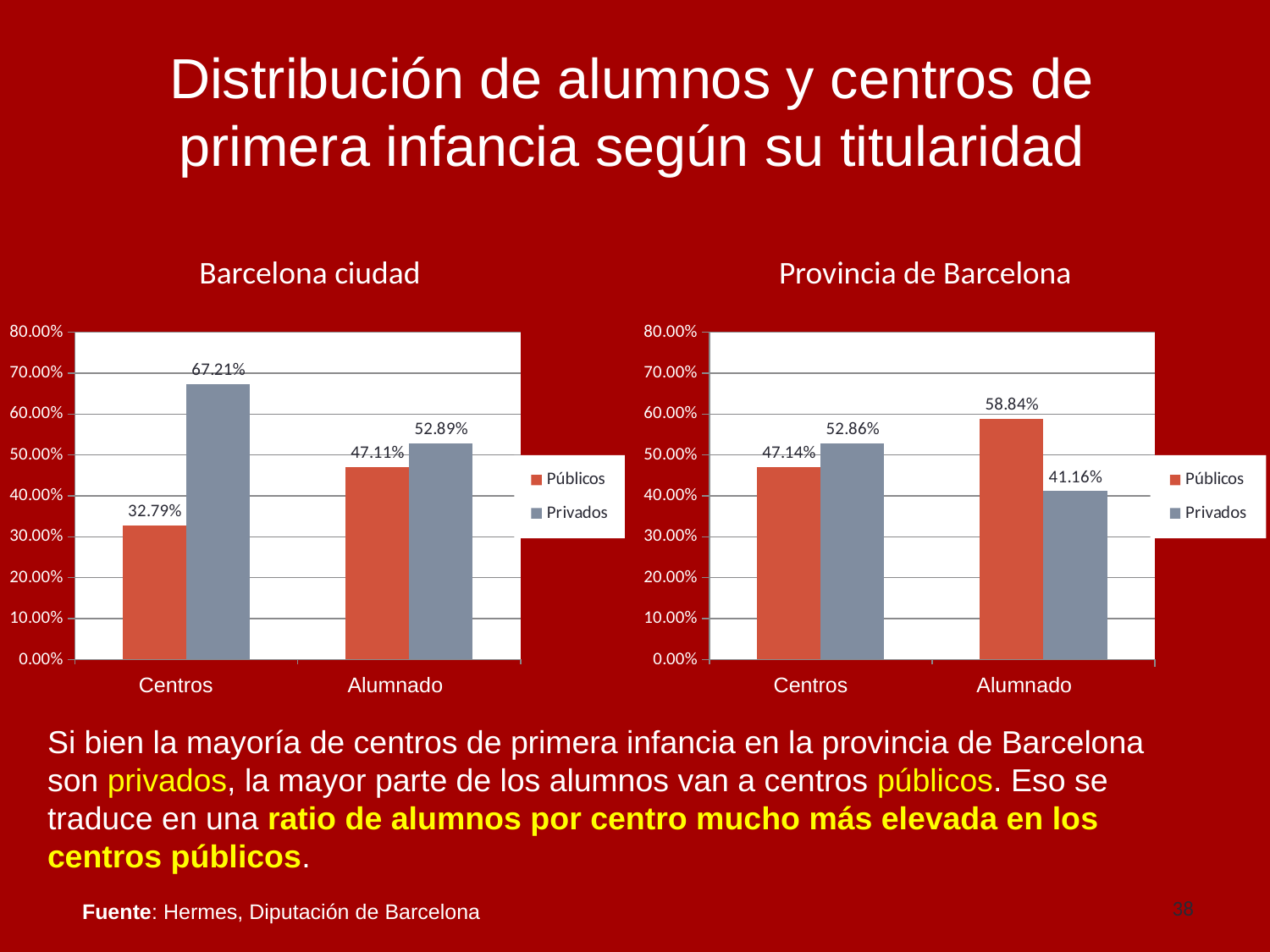
In the 'Barcelona ciudad' chart, what is the value for Privados in the Centros category? 67.21% In the 'Provincia de Barcelona' chart, what is the difference between Públicos and Privados in the Alumnado category? 17.68% In the 'Barcelona ciudad' chart, what is the value for Públicos in the Centros category? 32.79% How many series does the legend of the 'Barcelona ciudad' chart list? 2 In the 'Provincia de Barcelona' chart, what is the value for Privados in the Alumnado category? 41.16% In the 'Provincia de Barcelona' chart, which bar has the lowest value? Privados, Alumnado In the 'Provincia de Barcelona' chart, which is larger in the Centros category, Públicos or Privados? Privados In the 'Barcelona ciudad' chart, which bar has the highest value? Privados, Centros In the 'Provincia de Barcelona' chart, what is the value for Públicos in the Alumnado category? 58.84% In the 'Barcelona ciudad' chart, what is the difference between Privados and Públicos in the Alumnado category? 5.78% What kind of chart is the 'Provincia de Barcelona' chart? Bar chart In the 'Barcelona ciudad' chart, what colour are the Públicos bars? Orange-red